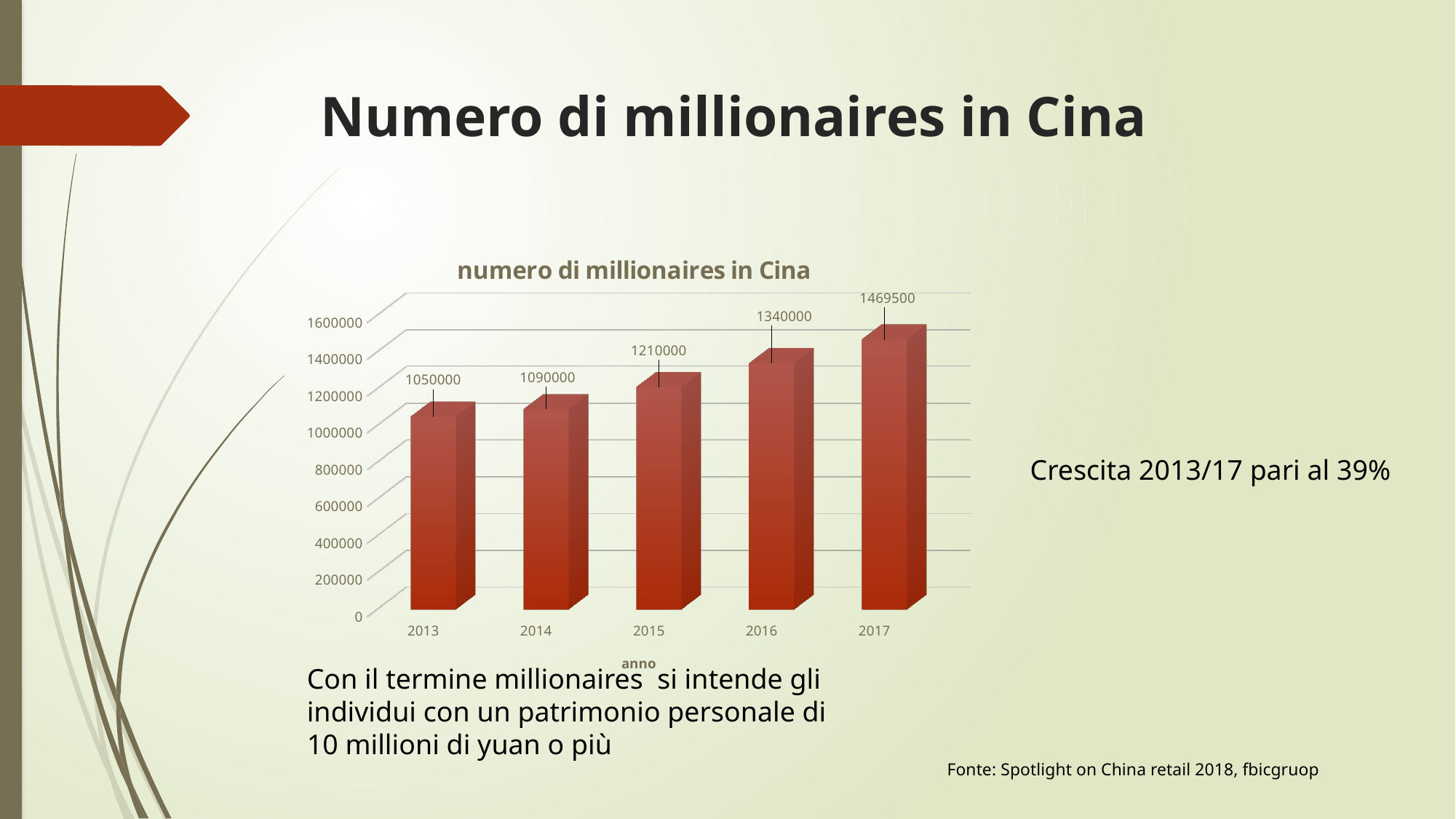
What is the value for 2013? 1050000 What is the difference between the values for 2017 and 2013? 419500 What is the difference between the values for 2016 and 2015? 130000 Which year has the highest value? 2017 Is the value for 2016 greater or less than 1200000? greater What kind of chart is shown? bar chart What is the value for 2015? 1210000 Do the values rise or fall from 2013 to 2017? rise Which is larger, the value for 2014 or the value for 2016? 2016 What is the value for 2017? 1469500 How many years are shown on the x axis? 5 Which year has the lowest value? 2013